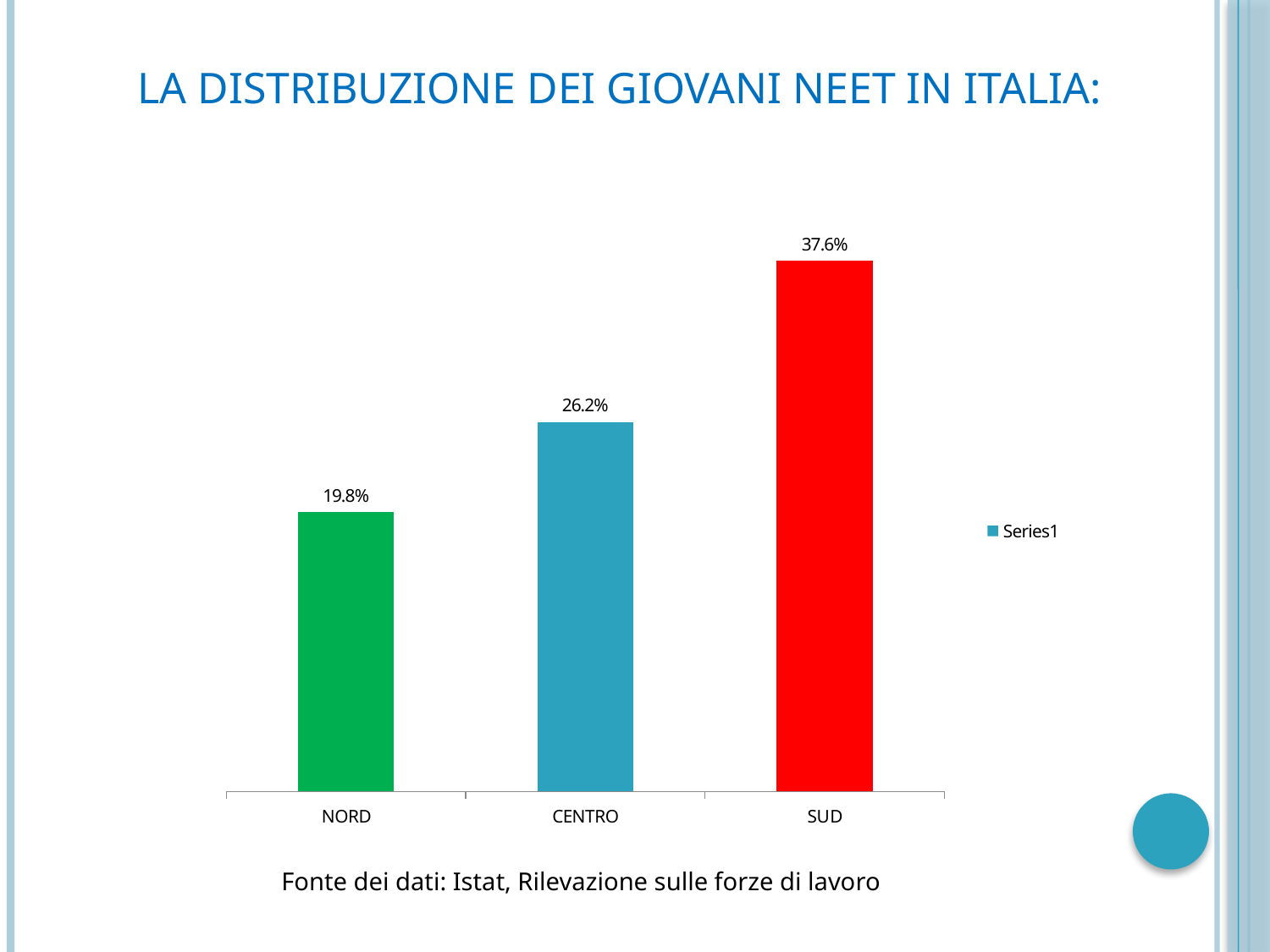
What is the value for NORD? 19.8% Which category has the lowest value? NORD Do the values rise or fall from NORD to SUD along the x axis? Rise What is the difference between the values for CENTRO and NORD? 6.4% How many categories are shown on the x axis? 3 What is the value for CENTRO? 26.2% How many series does the legend list? 1 What is the difference between the values for SUD and NORD? 17.8% Which is larger, the value for CENTRO or the value for SUD? SUD What kind of chart is shown on the slide? Bar chart Which category has the highest value? SUD What is the value for SUD? 37.6%